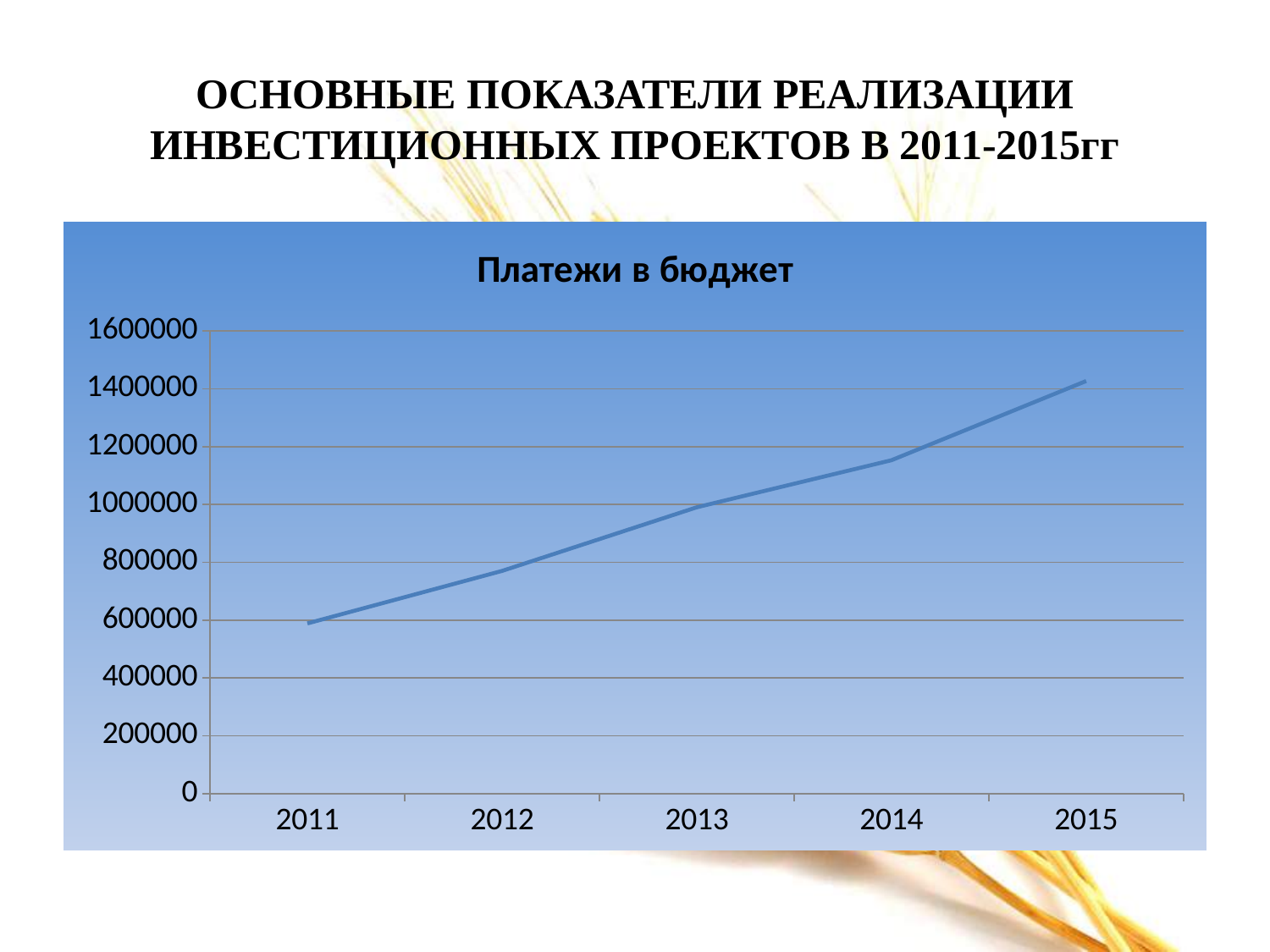
Is the value for 2012 greater or less than 600000? greater Is the value for 2015 greater or less than 1200000? greater Do the values for Платежи в бюджет rise or fall from 2011 to 2015? Rise Which year has the lowest value for Платежи в бюджет? 2011 How many years are plotted along the x axis of the chart? 5 Which year has the highest value for Платежи в бюджет? 2015 Is the value for 2015 greater or less than 1600000? less What is the title of the chart? Платежи в бюджет What kind of chart is shown on the slide? Line chart Which year has the larger value, 2012 or 2014? 2014